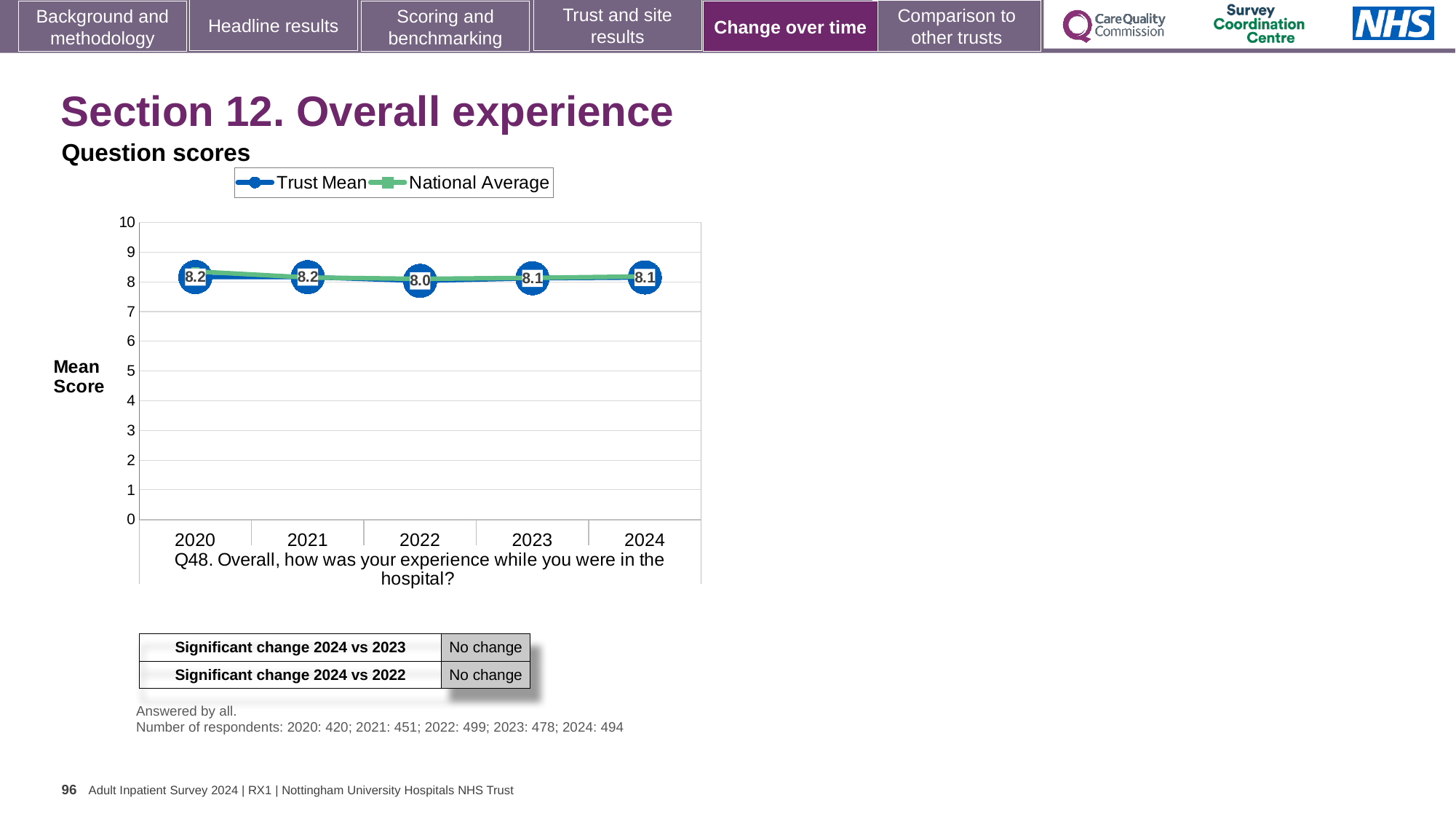
What is the Trust Mean score for 2023? 8.1 What is the difference between the Trust Mean scores for 2020 and 2022? 0.2 How many series does the legend list? 2 Is the Trust Mean score for 2022 greater or less than 5? greater What is the Trust Mean score for 2024? 8.1 What kind of chart is shown on the slide? Line chart What are the two series named in the legend? Trust Mean and National Average In which year is the Trust Mean score lowest? 2022 What is the Trust Mean score for 2022? 8.0 What is the Trust Mean score for 2020? 8.2 How many years are plotted on the x axis? 5 Which year has the larger Trust Mean score, 2021 or 2022? 2021